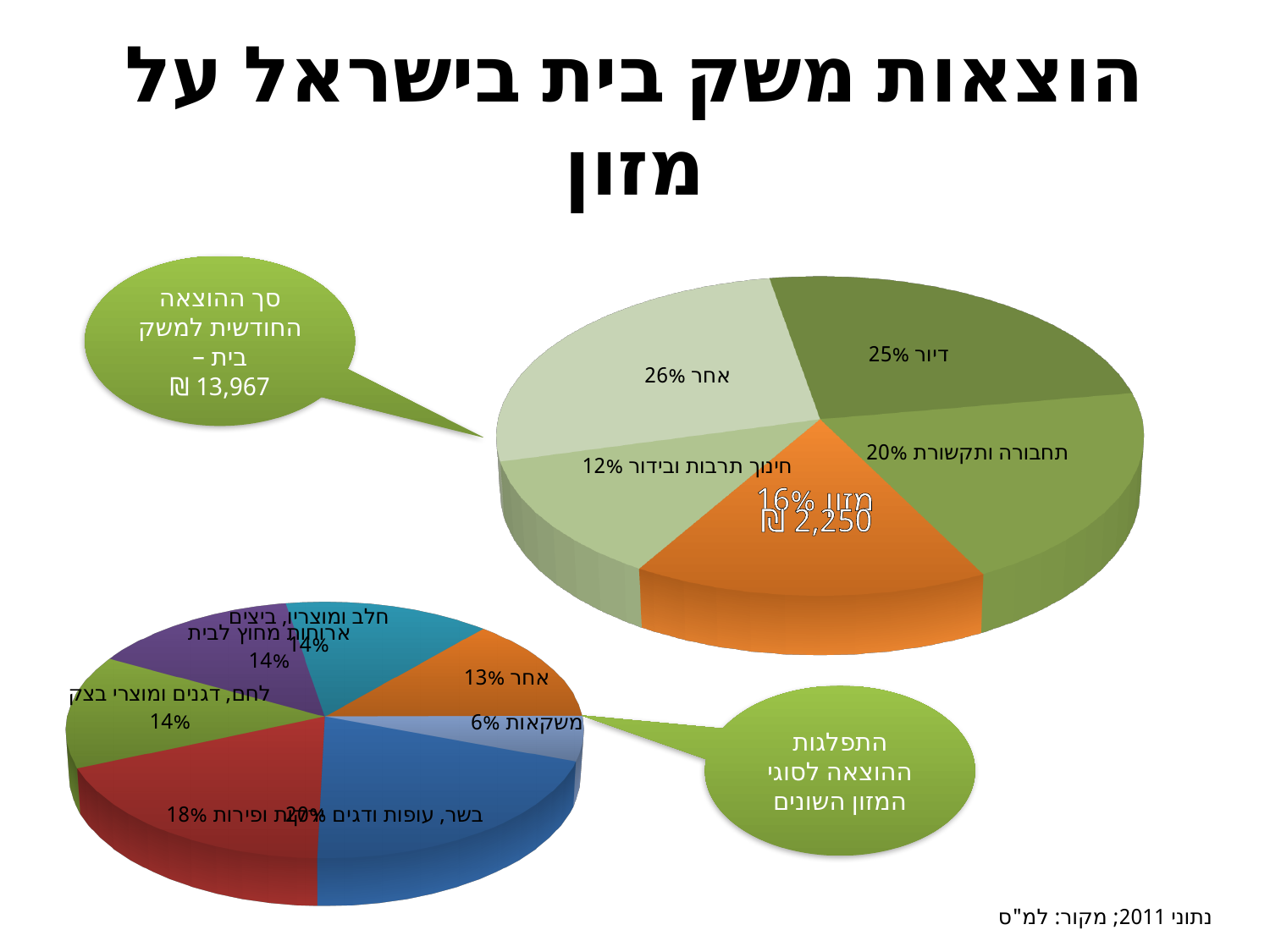
How many slices does the top-right pie chart have? 5 In the top-right pie chart, what monthly amount in shekels is shown on the מזון slice? 2,250 ₪ In the top-right pie chart, which category has the smallest share? חינוך תרבות ובידור In the top-right pie chart, what share of household expenditure is דיור? 25% In the bottom-left pie chart, which category has the smallest share? משקאות In the top-right pie chart, which category has the largest share? אחר In the bottom-left pie chart, what share is אחר? 13% In the top-right pie chart, what is the difference in percentage points between דיור and חינוך תרבות ובידור? 13 In the top-right pie chart, what share is מזון? 16% In the bottom-left pie chart, what share is משקאות? 6% What kind of chart is the bottom-left chart? Pie chart In the top-right pie chart, what share is תחבורה ותקשורת? 20%